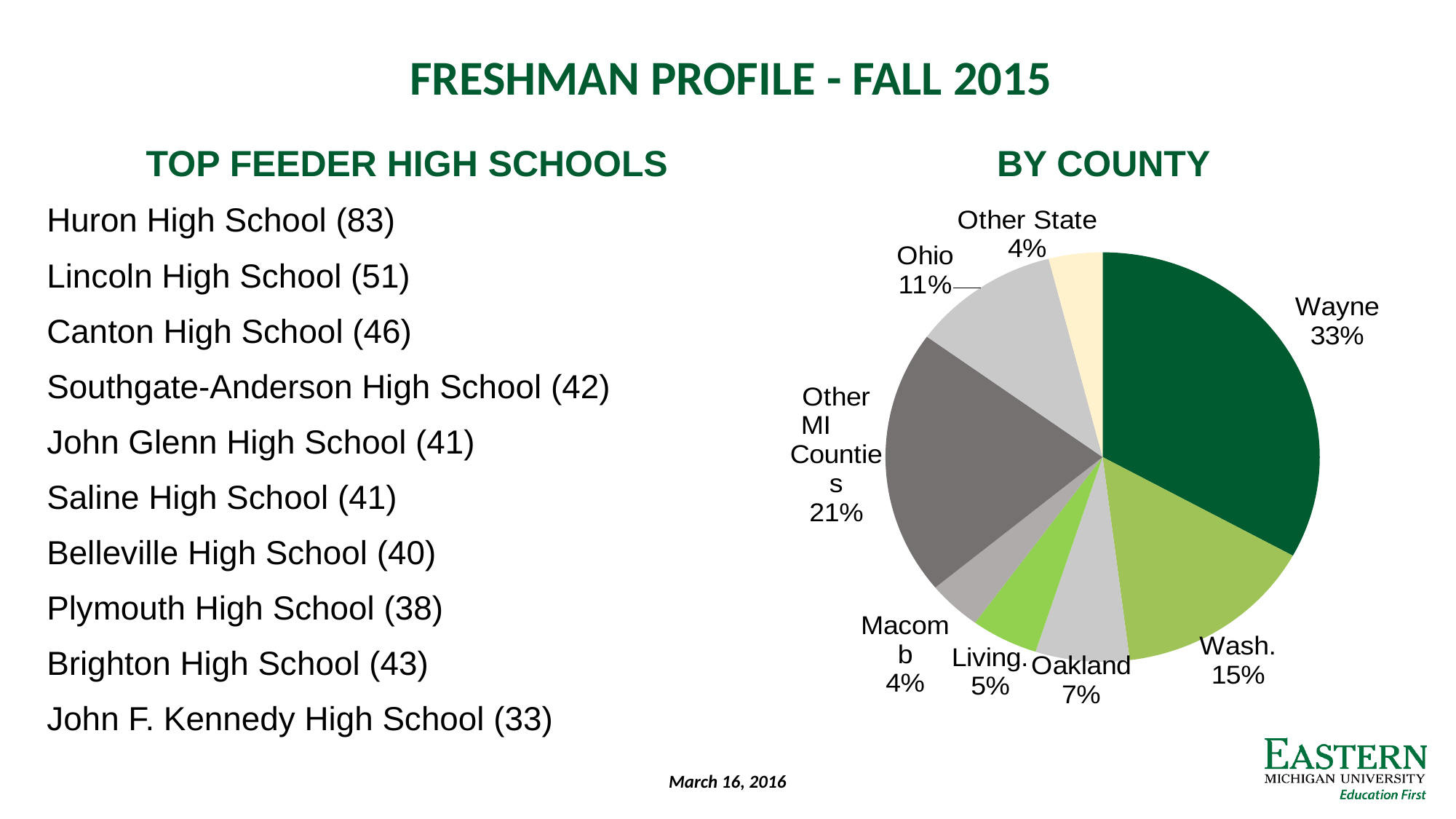
What percentage does the BY COUNTY pie chart show for Ohio? 11% What is the title of the pie chart on the slide? BY COUNTY What kind of chart is shown under the heading BY COUNTY? pie chart How many slices does the BY COUNTY pie chart have? 8 What share of the BY COUNTY pie chart is Wayne? 33% In the BY COUNTY pie chart, what is the difference in percentage points between Other MI Counties and Ohio? 10 In the BY COUNTY pie chart, how many percentage points larger is Wayne than Wash.? 18 What percentage does the BY COUNTY pie chart show for Oakland? 7% In the BY COUNTY pie chart, which is larger, Ohio or Oakland? Ohio What percentage does the BY COUNTY pie chart show for Other MI Counties? 21% Which slice of the BY COUNTY pie chart is the largest? Wayne In the BY COUNTY pie chart, which is larger, Living. or Macomb? Living.